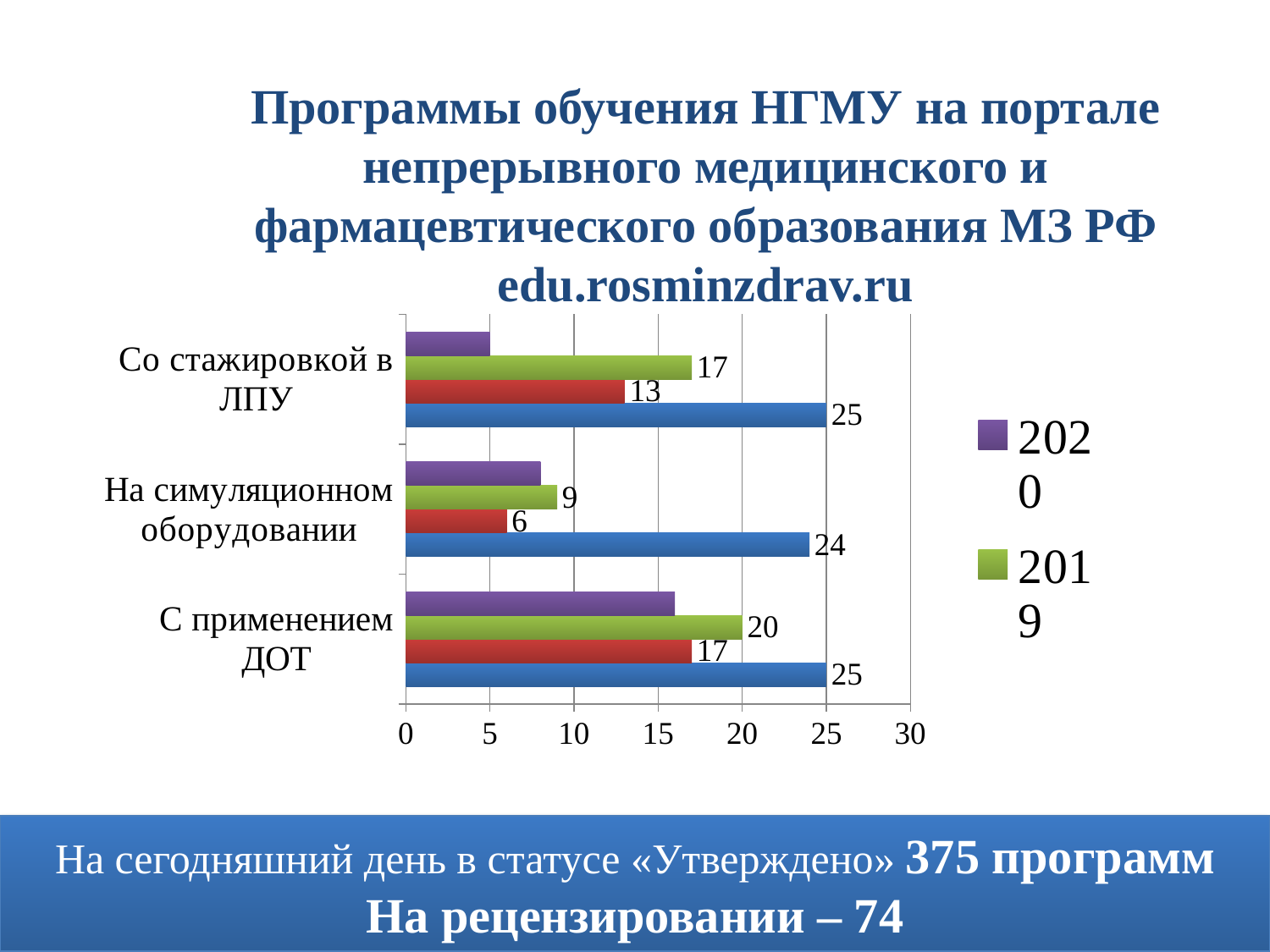
Is the 2020 value for «Со стажировкой в ЛПУ» greater or less than 10? less How many categories are shown on the chart? 3 Which category has the highest 2019 value? С применением ДОТ What value is labelled on the blue bar for «С применением ДОТ»? 25 Which category has the lowest 2019 value? На симуляционном оборудовании What is the difference between the 2019 values for «С применением ДОТ» and «На симуляционном оборудовании»? 11 What value is labelled on the red bar for «На симуляционном оборудовании»? 6 What is the 2019 value for «Со стажировкой в ЛПУ»? 17 Is the 2020 value for «С применением ДОТ» greater or less than 10? greater What is the 2019 value for «На симуляционном оборудовании»? 9 What is the 2019 value for «С применением ДОТ»? 20 For «Со стажировкой в ЛПУ», which is larger: the 2019 value or the 2020 value? 2019